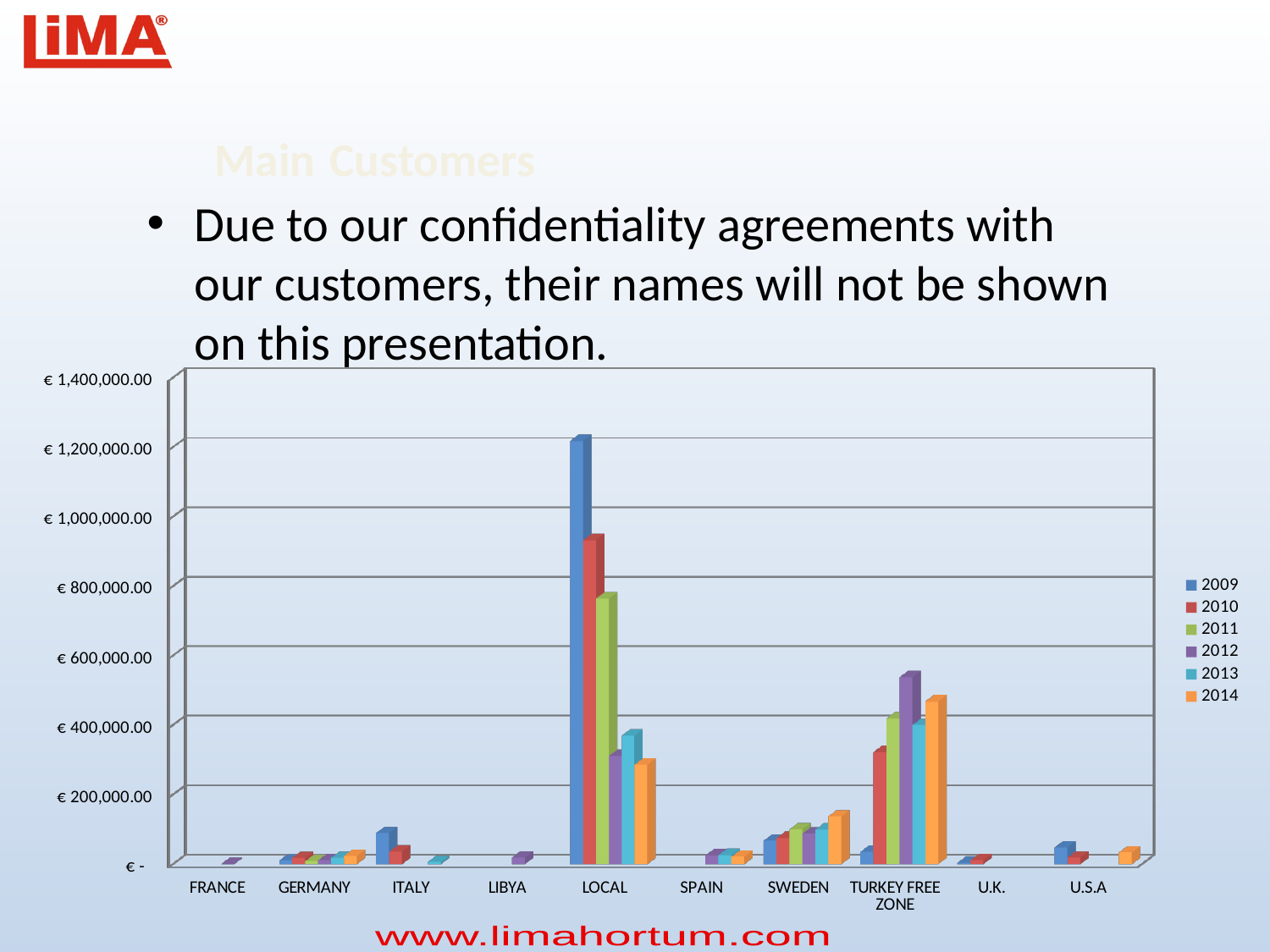
For LOCAL, do the values rise or fall from 2009 to 2011? fall How many categories are shown along the x axis of the chart? 10 Is the 2012 value for TURKEY FREE ZONE greater or less than € 400,000.00? greater Is the 2011 value for LOCAL greater or less than € 800,000.00? less Is the 2010 value for LOCAL greater or less than € 800,000.00? greater Which is larger for TURKEY FREE ZONE, the 2009 value or the 2012 value? 2012 Which year is listed first in the chart's legend? 2009 How many series does the chart's legend list? 6 Which category has the tallest bar in the chart? LOCAL What kind of chart is shown on the slide? bar chart Which is larger for LOCAL, the 2009 value or the 2010 value? 2009